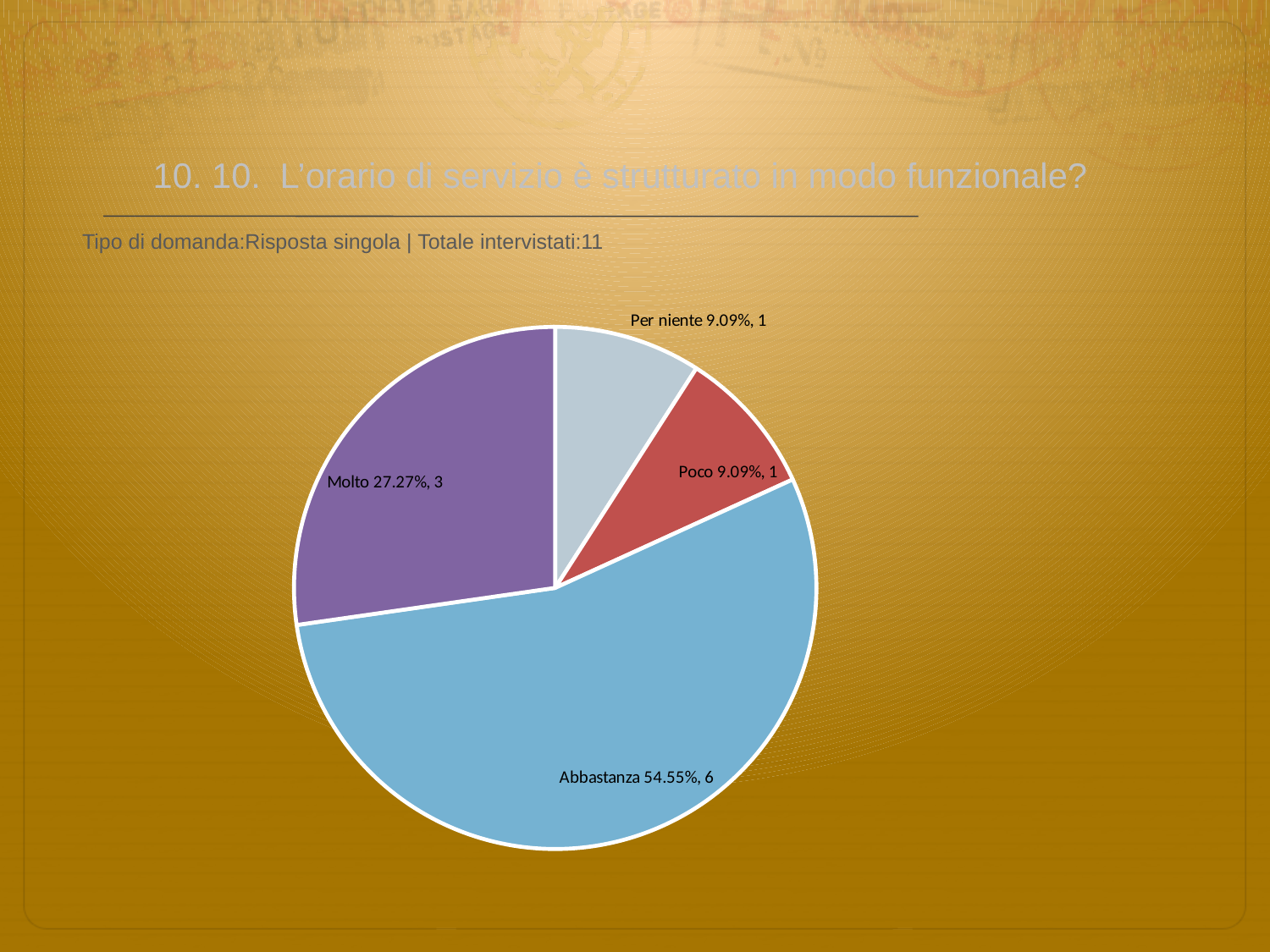
Which is larger, the Molto slice or the Poco slice? Molto What colour is the Abbastanza slice? light blue What is the title of the chart's question on the slide? 10. 10. L'orario di servizio è strutturato in modo funzionale? How many respondents answered Per niente? 1 How many slices does the pie chart have? 4 Which category has the largest slice? Abbastanza What kind of chart is shown on the slide? pie chart What is the difference in respondent count between Abbastanza and Molto? 3 What percentage share does the Abbastanza slice have? 54.55% What is the total number of respondents across all slices? 11 What percentage share does the Molto slice have? 27.27% How many respondents answered Molto? 3